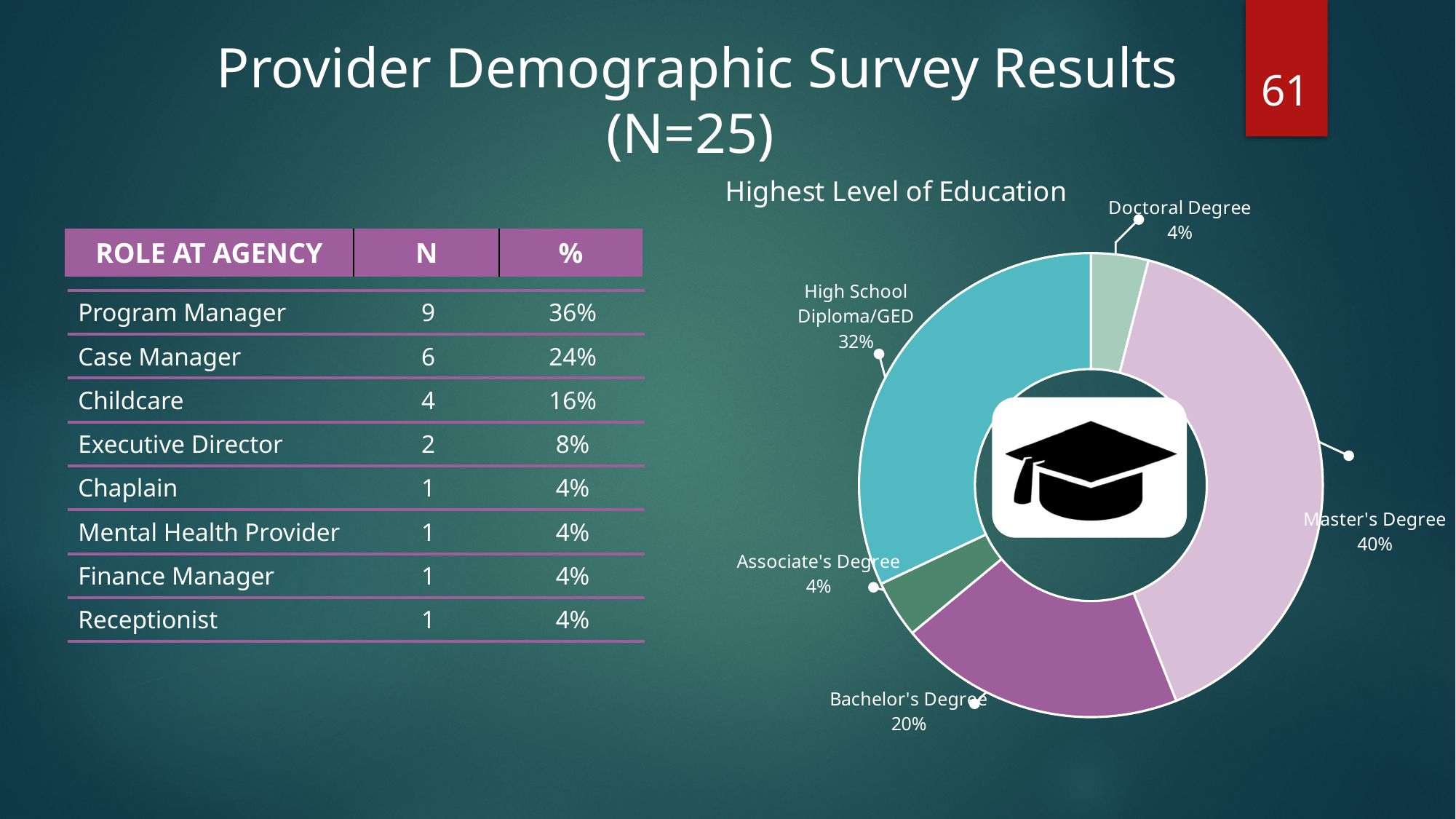
In the Highest Level of Education chart, which education level has the largest share? Master's Degree In the Highest Level of Education chart, what is the difference in percentage points between Master's Degree and Bachelor's Degree? 20 What kind of chart is the Highest Level of Education chart? Doughnut chart In the Highest Level of Education chart, what percentage is shown for Doctoral Degree? 4% In the Highest Level of Education chart, what percentage is shown for Bachelor's Degree? 20% In the Highest Level of Education chart, what percentage is shown for Associate's Degree? 4% In the Highest Level of Education chart, what is the difference in percentage points between High School Diploma/GED and Doctoral Degree? 28 In the Highest Level of Education chart, which is larger: the share for High School Diploma/GED or the share for Bachelor's Degree? High School Diploma/GED What is the title of the chart on the right side of the slide? Highest Level of Education How many education levels are shown in the Highest Level of Education chart? 5 In the Highest Level of Education chart, what share of respondents hold a Master's Degree? 40% In the Highest Level of Education chart, what percentage is shown for High School Diploma/GED? 32%